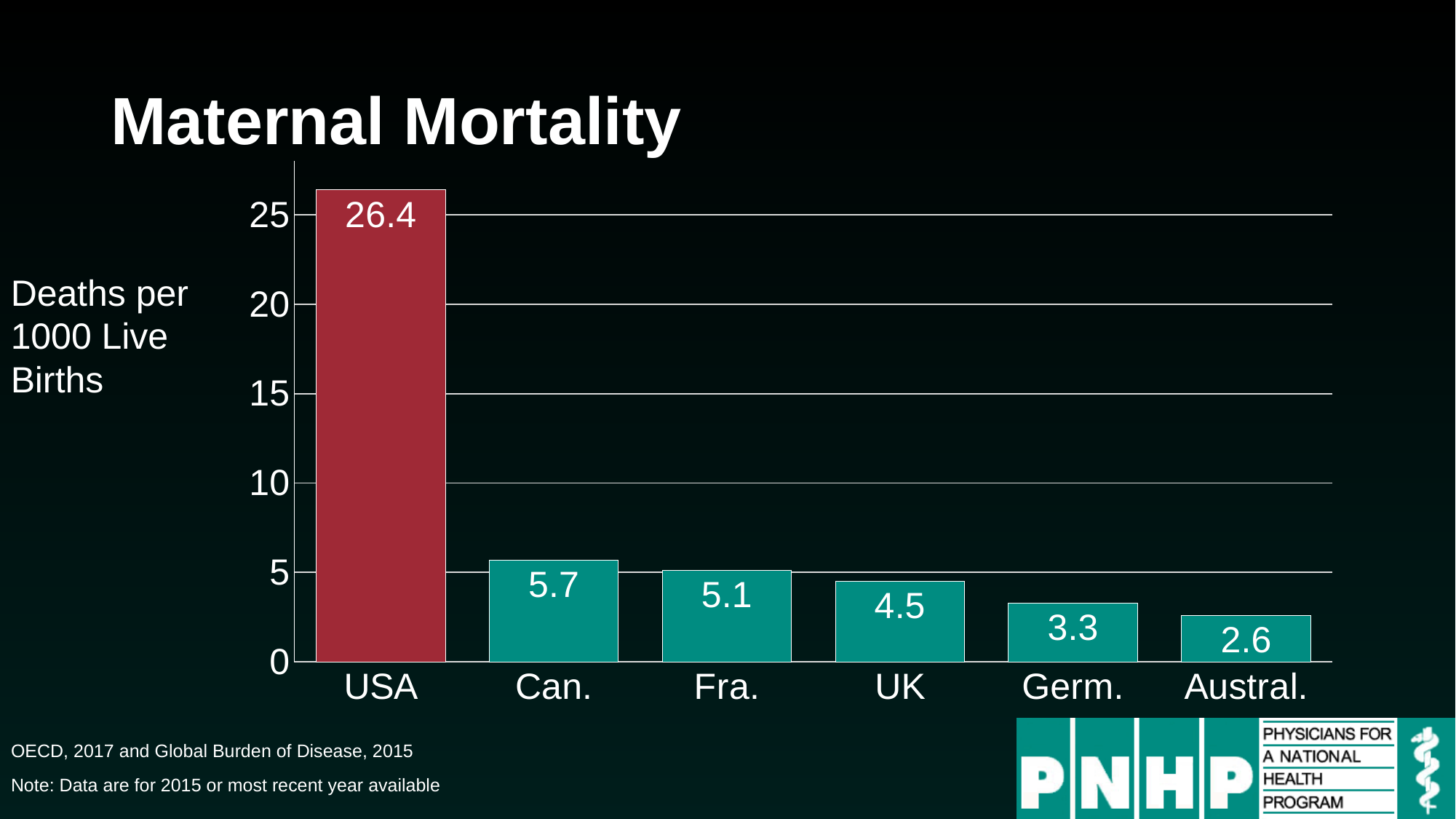
What is the difference between the Fra. value and the Austral. value? 2.5 Which has a higher value, Can. or Fra.? Can. Is the value for the USA greater or less than 25? greater What is the difference between the USA value and the Can. value? 20.7 Which country has the highest maternal mortality on the chart? USA What unit does the y-axis label say the values are measured in? Deaths per 1000 Live Births What kind of chart is shown on the slide? bar chart What is the maternal mortality value for the USA? 26.4 How many countries are shown on the chart? 6 What is the value shown for the UK? 4.5 What is the maternal mortality value for Germ.? 3.3 Which country has the lowest maternal mortality on the chart? Austral.